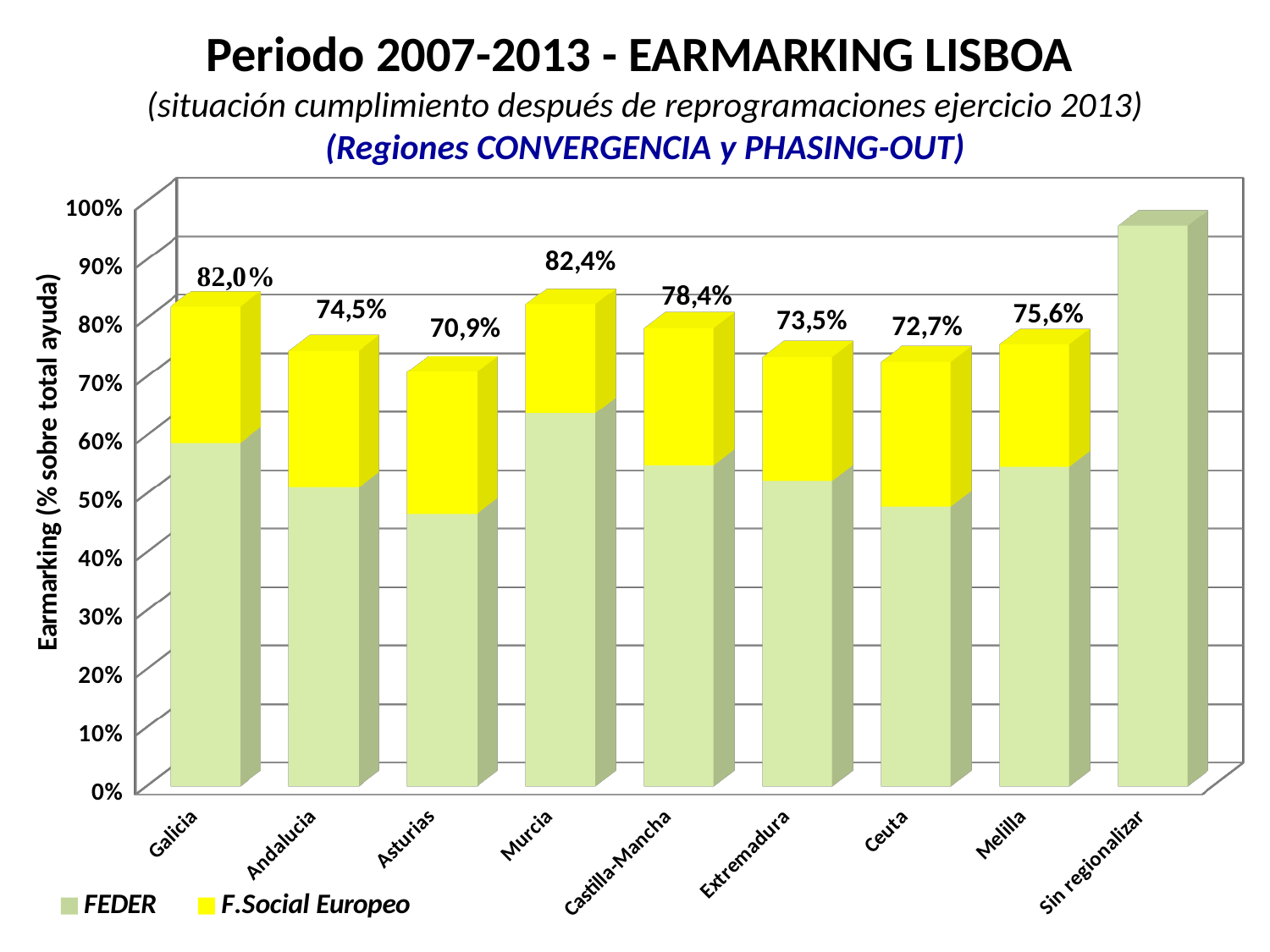
What is the total earmarking value shown for Galicia? 82,0% Which category has the tallest bar in the chart? Sin regionalizar Is the value for Sin regionalizar greater or less than 90%? greater How many categories are shown on the x axis? 9 What is the total earmarking value shown for Asturias? 70,9% What is the difference between the total values for Andalucia and Asturias? 3,6 percentage points How many series does the legend list? 2 What kind of chart is shown on the slide? Stacked bar chart Among the categories with a printed total label, which has the lowest value? Asturias What is the total earmarking value shown for Castilla-Mancha? 78,4% Which has a higher total value, Melilla or Extremadura? Melilla What is the total earmarking value shown for Murcia? 82,4%